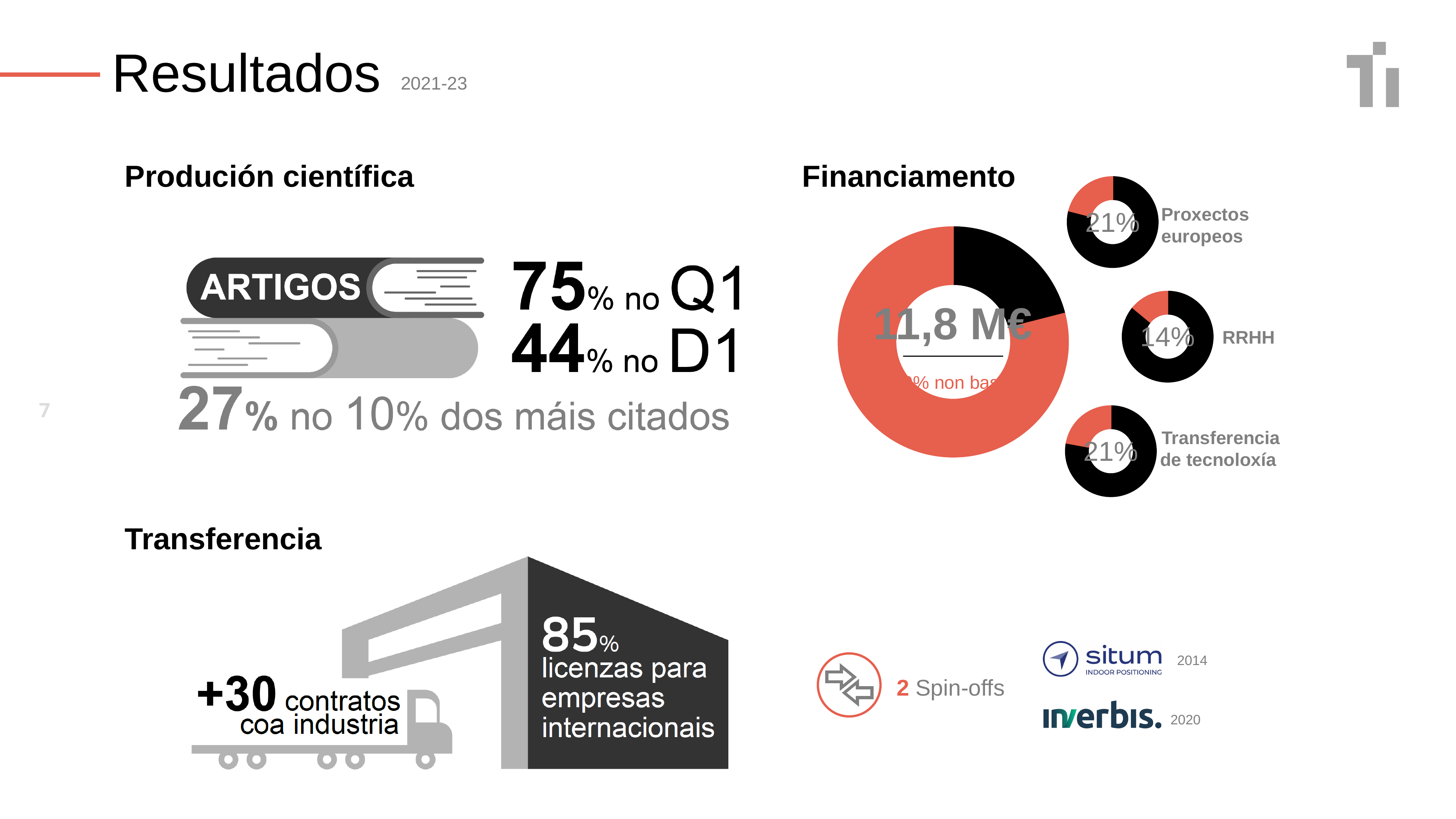
In the Financiamento section, what percentage is shown for Proxectos europeos? 21% In the Financiamento section, what percentage is shown for RRHH? 14% What kind of chart is used in the Financiamento section of the slide? Donut (pie) chart How many small donut charts are shown in the Financiamento section? 3 Among the three small donut charts in the Financiamento section, which category has the lowest percentage? RRHH In the Financiamento section, what is the difference between the percentage for Transferencia de tecnoloxía and the percentage for RRHH? 7 percentage points What value is printed in the centre of the large donut chart in the Financiamento section? 11,8 M€ In the Financiamento section, which is larger: the percentage for Proxectos europeos or for RRHH? Proxectos europeos In the large donut chart in the Financiamento section, which segment is larger: the red one or the black one? Red In the large donut chart in the Financiamento section, is the red segment greater or less than 50% of the ring? greater In the Financiamento section, what percentage is shown for Transferencia de tecnoloxía? 21% What is the title of the section containing the donut charts? Financiamento